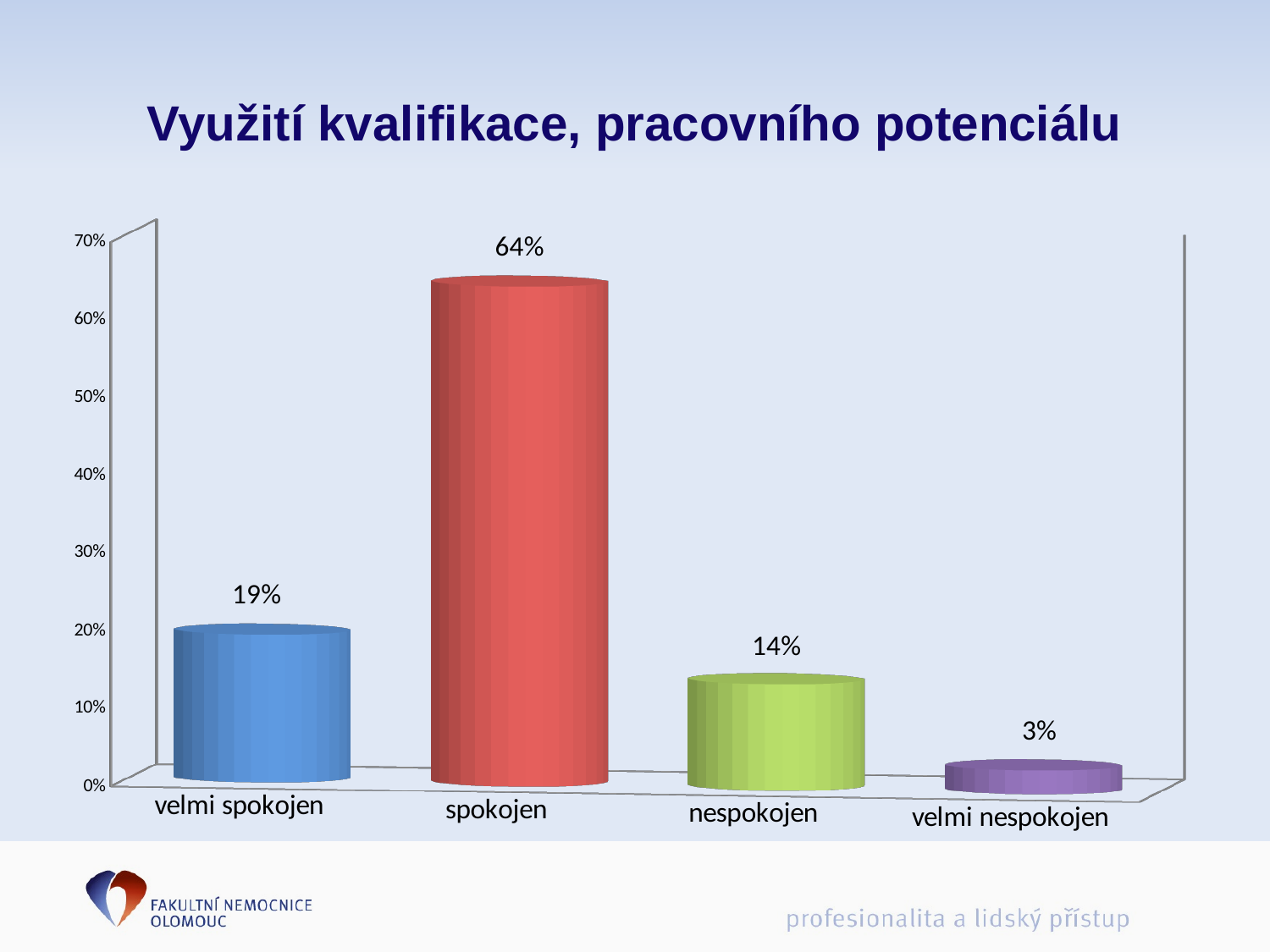
What is the difference between the values for "spokojen" and "velmi spokojen"? 45% What is the value for "velmi nespokojen"? 3% What kind of chart is shown on the slide? bar chart Which category has the lowest value? velmi nespokojen What is the value for "spokojen"? 64% Which category has the highest value? spokojen What is the value for "nespokojen"? 14% What is the title of the chart? Využití kvalifikace, pracovního potenciálu How many categories are shown on the x axis? 4 Is the value for "spokojen" greater or less than 60%? greater Which is larger, the value for "velmi spokojen" or the value for "nespokojen"? velmi spokojen What is the value for "velmi spokojen"? 19%